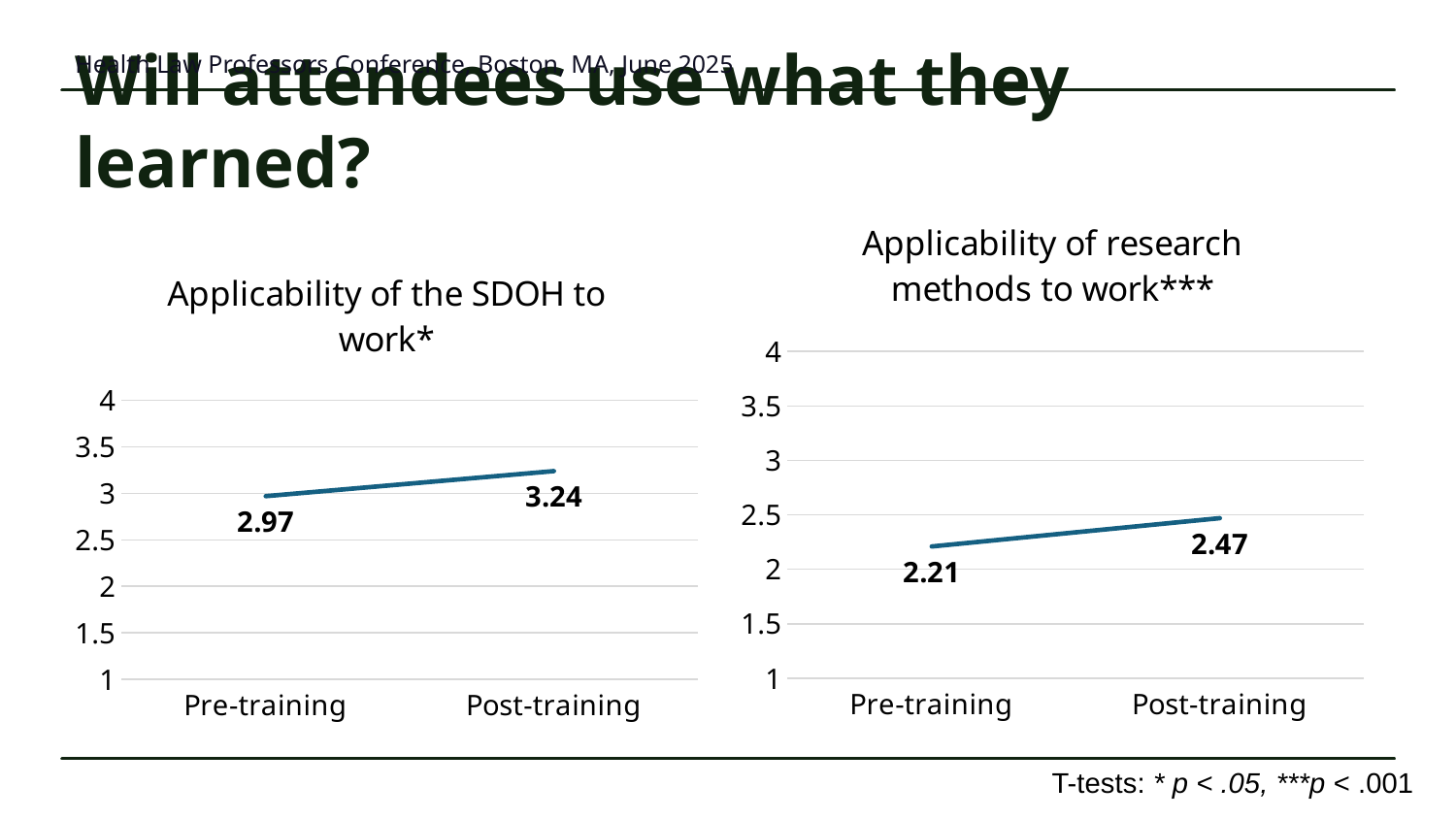
In the 'Applicability of the SDOH to work*' chart, which is larger, the Pre-training or Post-training value? Post-training In the 'Applicability of the SDOH to work*' chart, what is the Post-training value? 3.24 In the 'Applicability of the SDOH to work*' chart, what is the difference between the Post-training and Pre-training values? 0.27 In the 'Applicability of research methods to work***' chart, what is the Pre-training value? 2.21 In the 'Applicability of research methods to work***' chart, do the values rise or fall from Pre-training to Post-training? rise In the 'Applicability of research methods to work***' chart, what is the difference between the Post-training and Pre-training values? 0.26 What is the title of the chart on the right side of the slide? Applicability of research methods to work*** In the 'Applicability of research methods to work***' chart, is the Post-training value greater or less than 3? less In the 'Applicability of research methods to work***' chart, what is the Post-training value? 2.47 In the 'Applicability of the SDOH to work*' chart, what is the Pre-training value? 2.97 How many categories are shown on the x axis of the 'Applicability of research methods to work***' chart? 2 What kind of chart is the 'Applicability of the SDOH to work*' chart? line chart